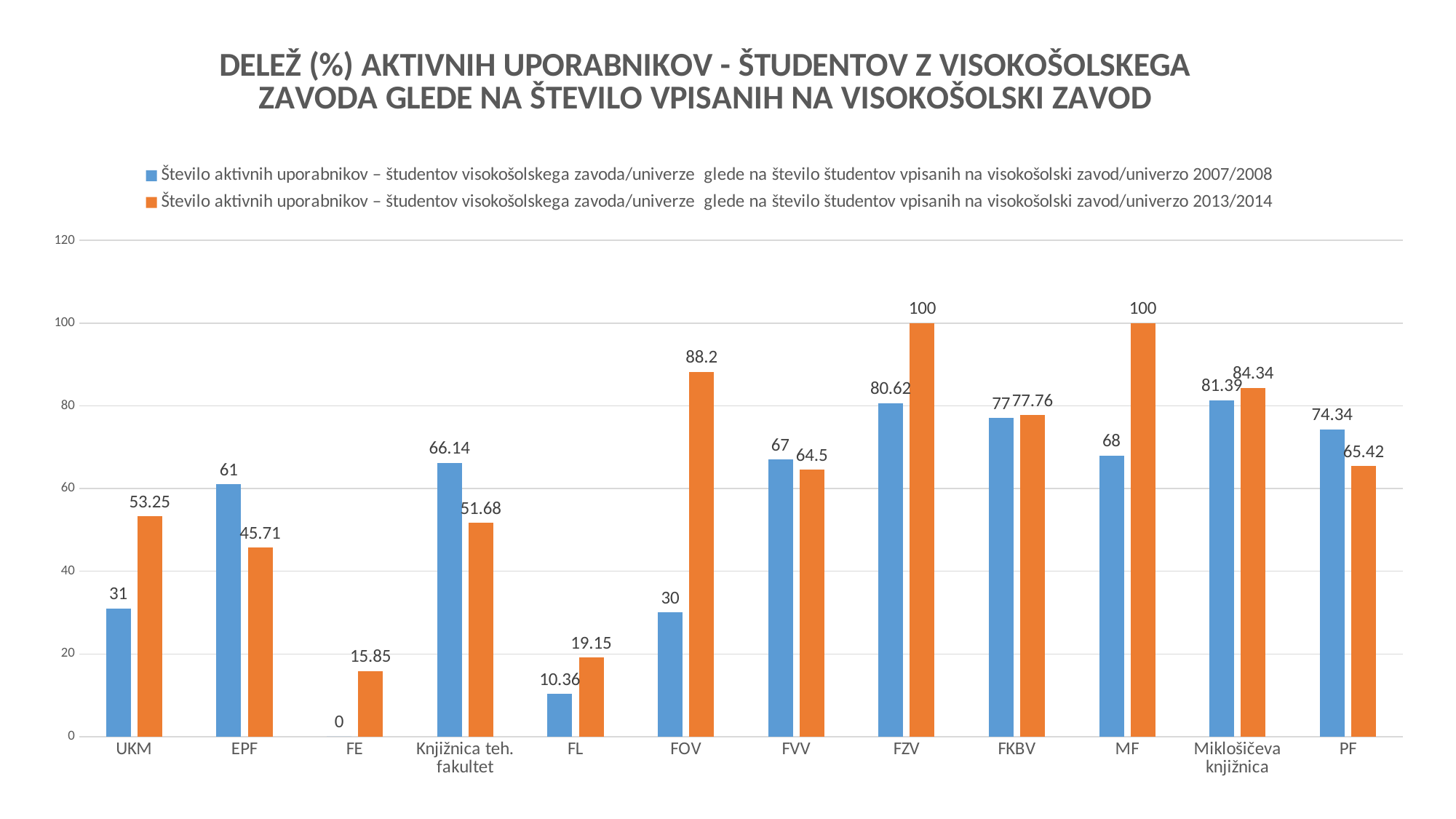
What is the 2007/2008 value for Knjižnica teh. fakultet? 66.14 How many categories are shown on the x axis? 12 What is the difference between the 2013/2014 and 2007/2008 values for FOV? 58.2 Which category has the lowest 2007/2008 value? FE Which category has the highest 2007/2008 value? Miklošičeva knjižnica What kind of chart is this? bar chart What is the 2013/2014 value for FE? 15.85 For PF, which is larger: the 2007/2008 value or the 2013/2014 value? 2007/2008 What is the 2013/2014 value for FOV? 88.2 What is the 2007/2008 value for UKM? 31 How many series does the legend list? 2 Which categories reach a 2013/2014 value of 100? FZV and MF